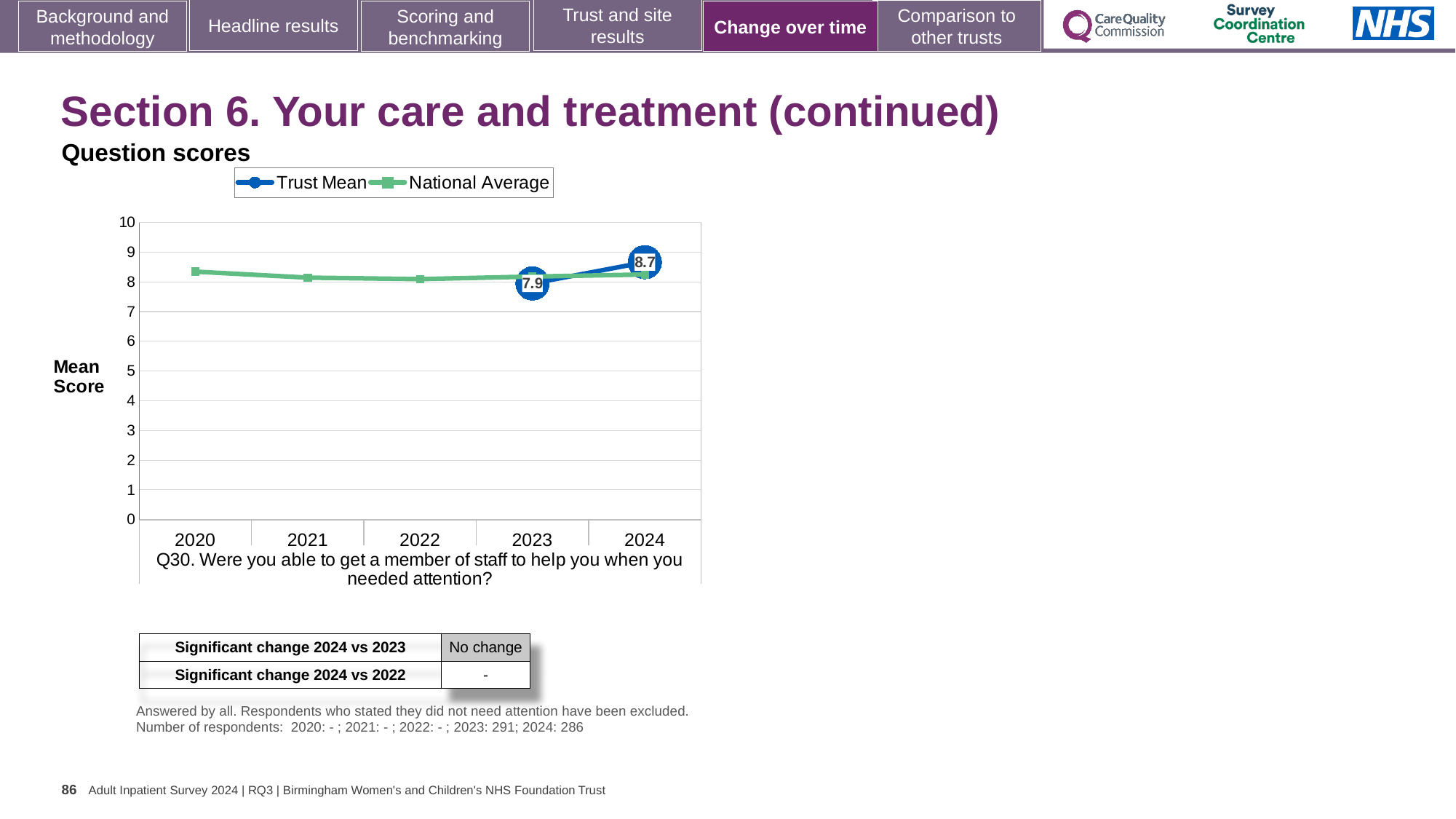
What is the label on the y axis of the chart? Mean Score Is the National Average value for 2021 greater or less than 7? greater Does the Trust Mean rise or fall from 2023 to 2024? rise What is the difference between the Trust Mean in 2024 and the Trust Mean in 2023? 0.8 In 2024, which is higher, the Trust Mean or the National Average? Trust Mean How many years are shown on the x axis? 5 Is the National Average value for 2020 greater or less than 9? less Which year has the higher Trust Mean, 2023 or 2024? 2024 What is the Trust Mean value for 2023? 7.9 How many series does the legend list? 2 What is the Trust Mean value for 2024? 8.7 What kind of chart is shown on the slide? line chart